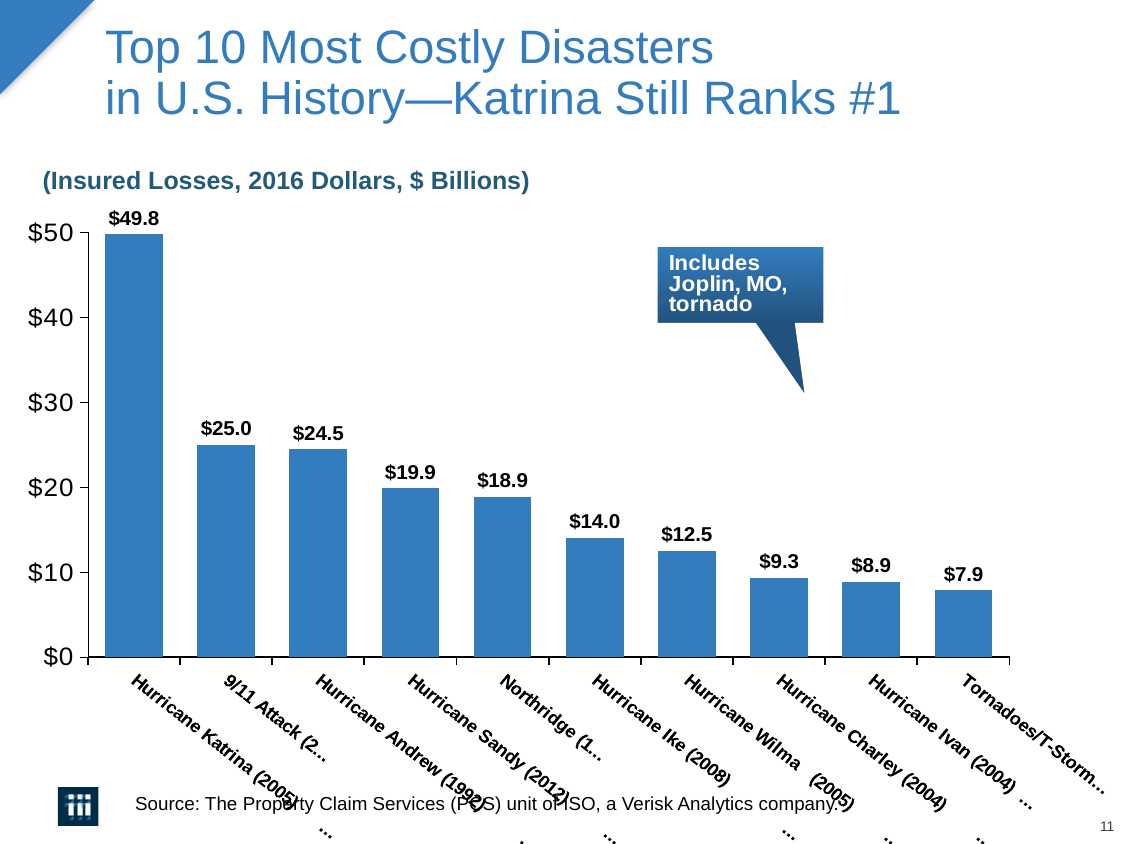
What is the insured loss value shown for Hurricane Charley (2004)? $9.3 Which has a larger insured loss, Hurricane Sandy (2012) or Hurricane Ivan (2004)? Hurricane Sandy (2012) What is the insured loss value shown for Hurricane Sandy (2012)? $19.9 What is the difference between the insured losses for Hurricane Ike (2008) and Hurricane Wilma (2005)? $1.5 What is the difference between the insured losses for Hurricane Katrina (2005) and Hurricane Andrew (1992)? $25.3 What is the insured loss value shown for Hurricane Ike (2008)? $14.0 Which disaster has the lowest insured loss on the chart? Tornadoes/T-Storm Do the values rise or fall moving from left to right along the x axis? Fall What type of chart is shown on the slide? Bar chart Which disaster has the highest insured loss on the chart? Hurricane Katrina (2005) How many disasters are plotted on the chart? 10 What is the insured loss value shown for Hurricane Katrina (2005)? $49.8